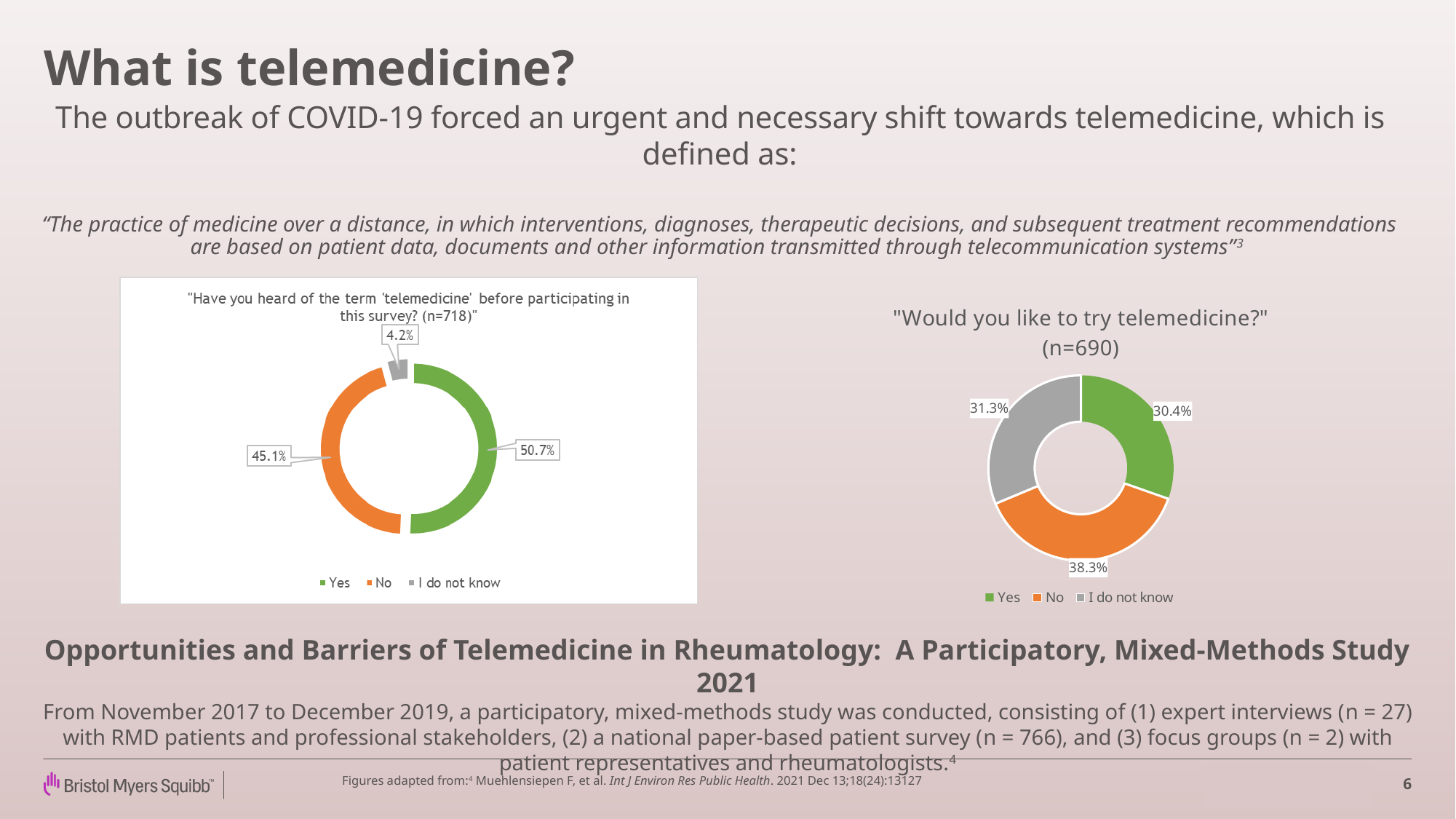
In the left chart ("Have you heard of the term 'telemedicine'..."), what is the difference in percentage points between Yes and No? 5.6 In the right chart ("Would you like to try telemedicine?"), which is larger: the share for Yes or the share for "I do not know"? I do not know What kind of chart is the left chart ("Have you heard of the term 'telemedicine'...")? Doughnut chart How many series does the legend of the right chart ("Would you like to try telemedicine?") list? 3 In the right chart ("Would you like to try telemedicine?"), which response has the largest share? No In the right chart ("Would you like to try telemedicine?"), what percentage answered No? 38.3% In the left chart ("Have you heard of the term 'telemedicine'..."), what percentage answered "I do not know"? 4.2% In the left chart ("Have you heard of the term 'telemedicine'..."), what percentage answered No? 45.1% In the right chart ("Would you like to try telemedicine?"), what is the difference in percentage points between No and Yes? 7.9 In the left chart ("Have you heard of the term 'telemedicine'..."), which response has the smallest share? I do not know In the right chart ("Would you like to try telemedicine?"), what percentage answered Yes? 30.4% In the left chart ("Have you heard of the term 'telemedicine' before participating in this survey?"), what percentage answered Yes? 50.7%